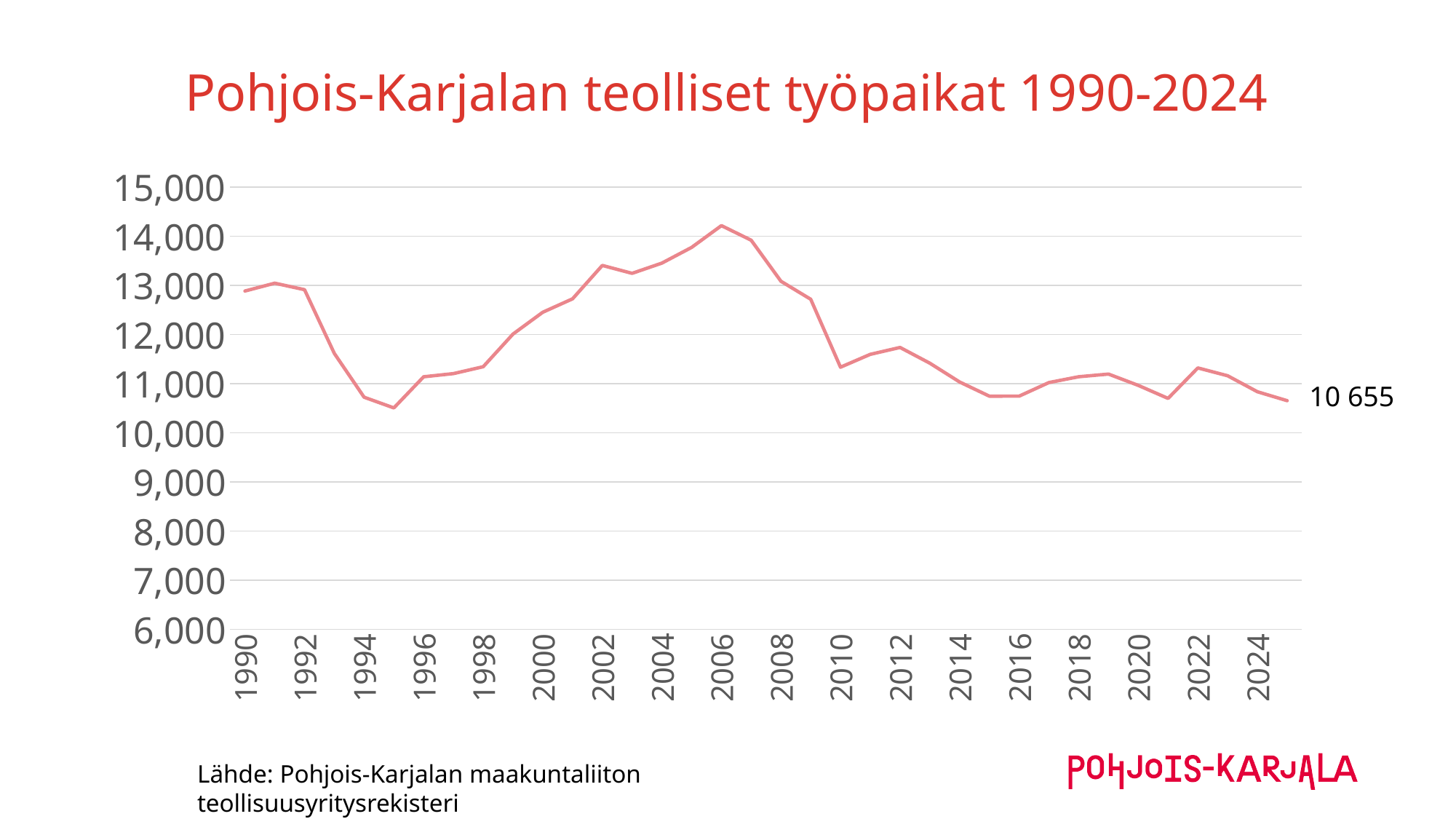
Which year has the larger value, 2006 or 2010? 2006 Which year has the larger value, 1990 or 2024? 1990 In which year does the line reach its highest value? 2006 Is the value for 2016 greater or less than 11,000? less What value is printed as the data label at the end of the line? 10 655 Does the line rise or fall between 2006 and 2010? fall Is the value for 2002 greater or less than 13,000? greater Is the value for 2010 greater or less than 12,000? less What kind of chart is shown on the slide? line chart What is the title of the chart? Pohjois-Karjalan teolliset työpaikat 1990-2024 What is the lowest value shown on the vertical axis? 6,000